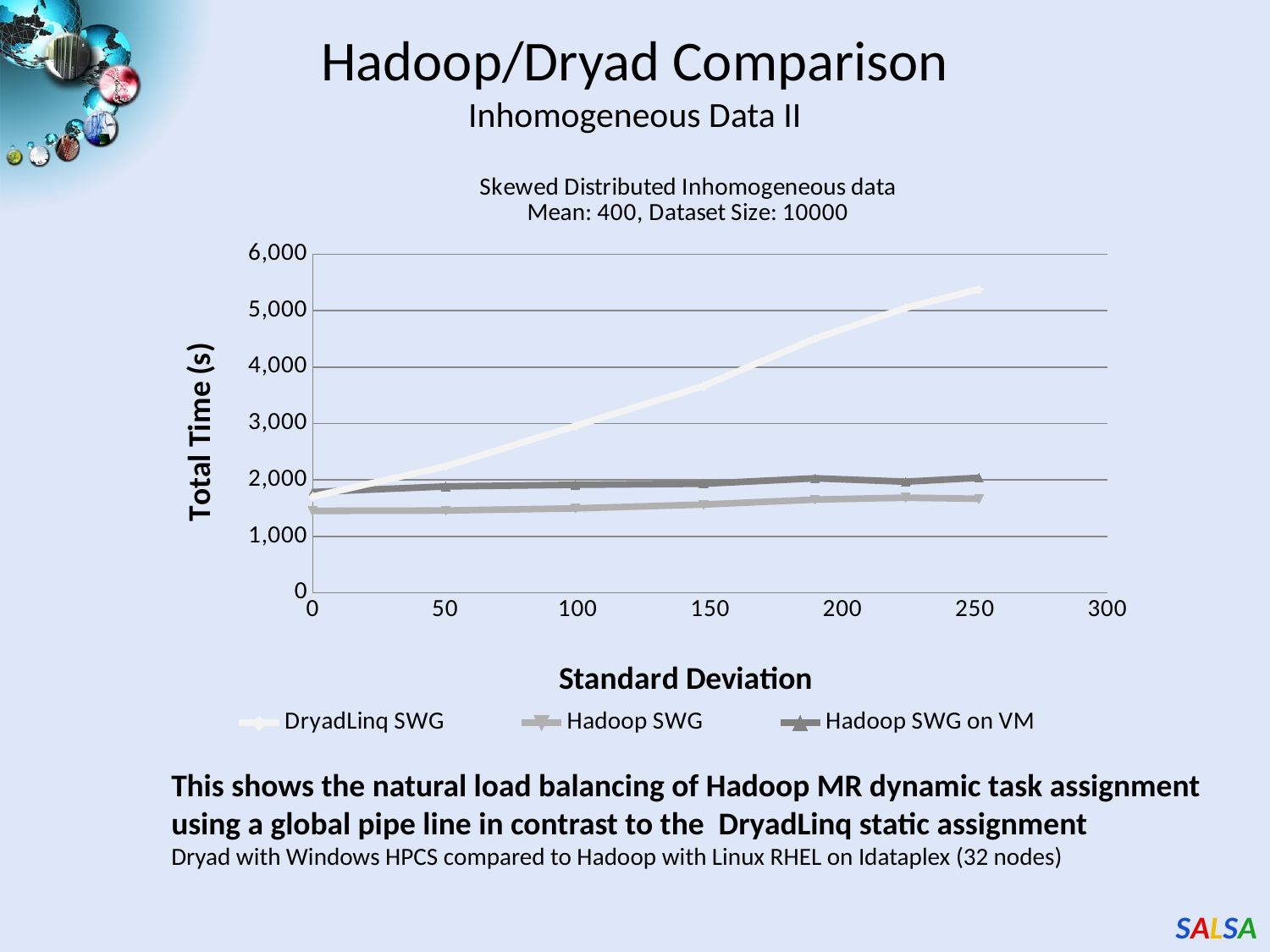
What is the label of the y axis? Total Time (s) What is the label of the x axis? Standard Deviation Is the total time for DryadLinq SWG at a standard deviation of 250 greater or less than 5,000? greater Which series has the lowest total time at a standard deviation of 250? Hadoop SWG At a standard deviation of 250, which is larger: the total time for Hadoop SWG on VM or for Hadoop SWG? Hadoop SWG on VM Is the total time for DryadLinq SWG at a standard deviation of 150 greater or less than 3,000? greater Does the total time for DryadLinq SWG rise or fall as the standard deviation increases? rise At a standard deviation of 200, which is larger: the total time for DryadLinq SWG or for Hadoop SWG on VM? DryadLinq SWG Is the total time for Hadoop SWG at a standard deviation of 0 greater or less than 2,000? less How many series does the legend list? 3 Which series has the highest total time at a standard deviation of 250? DryadLinq SWG What kind of chart is shown on the slide? line chart